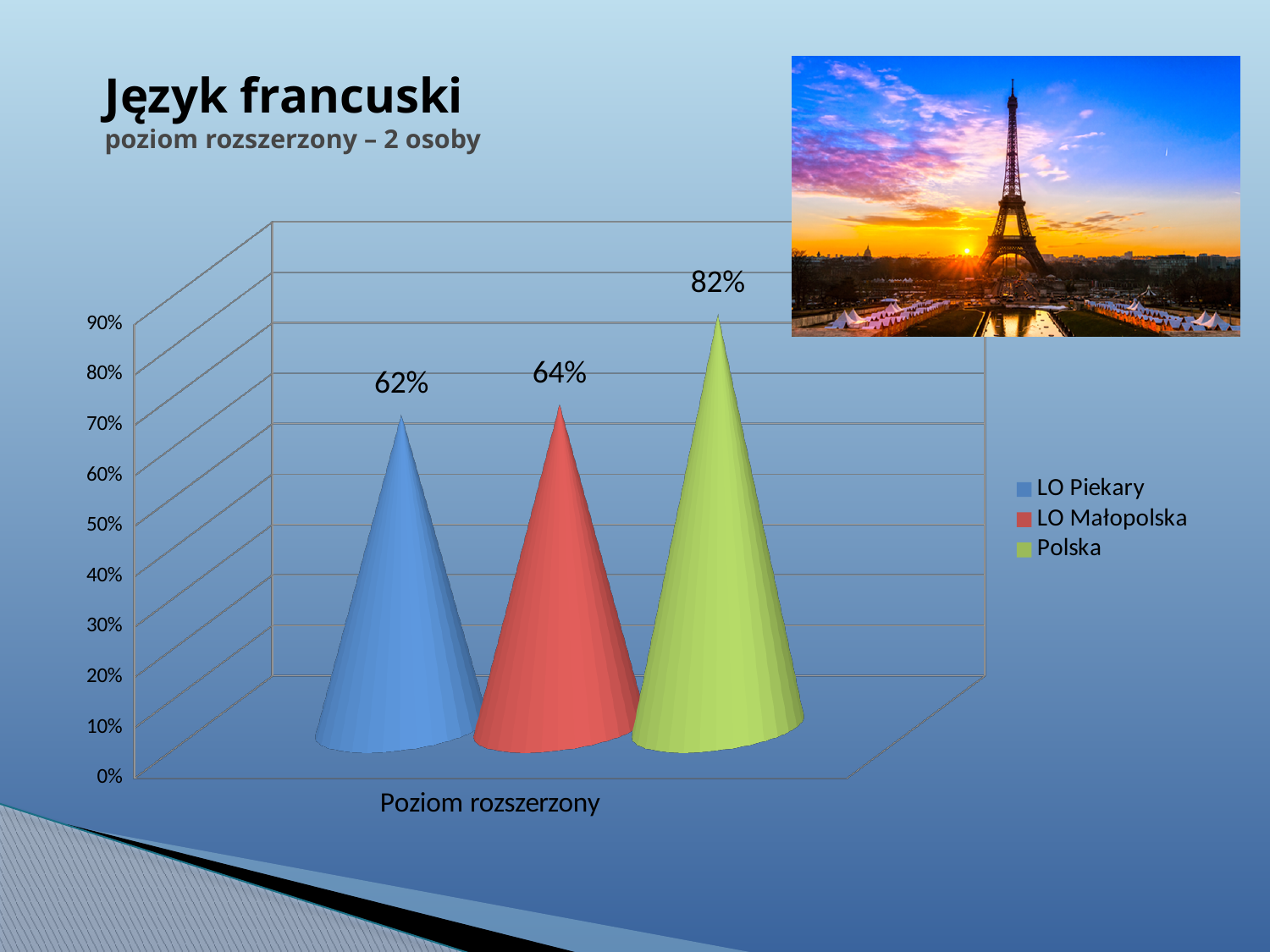
What kind of chart is shown on the slide? bar chart What is the value for LO Małopolska? 64% Which series has the highest value? Polska What is the label on the x axis of the chart? Poziom rozszerzony What is the value for LO Piekary? 62% Which series has the lowest value? LO Piekary Which is larger, the value for Polska or the value for LO Małopolska? Polska What is the difference between the values for LO Małopolska and LO Piekary? 2% What is the difference between the values for Polska and LO Piekary? 20% How many series does the legend list? 3 What is the value for Polska? 82% Which colour represents Polska in the legend? green